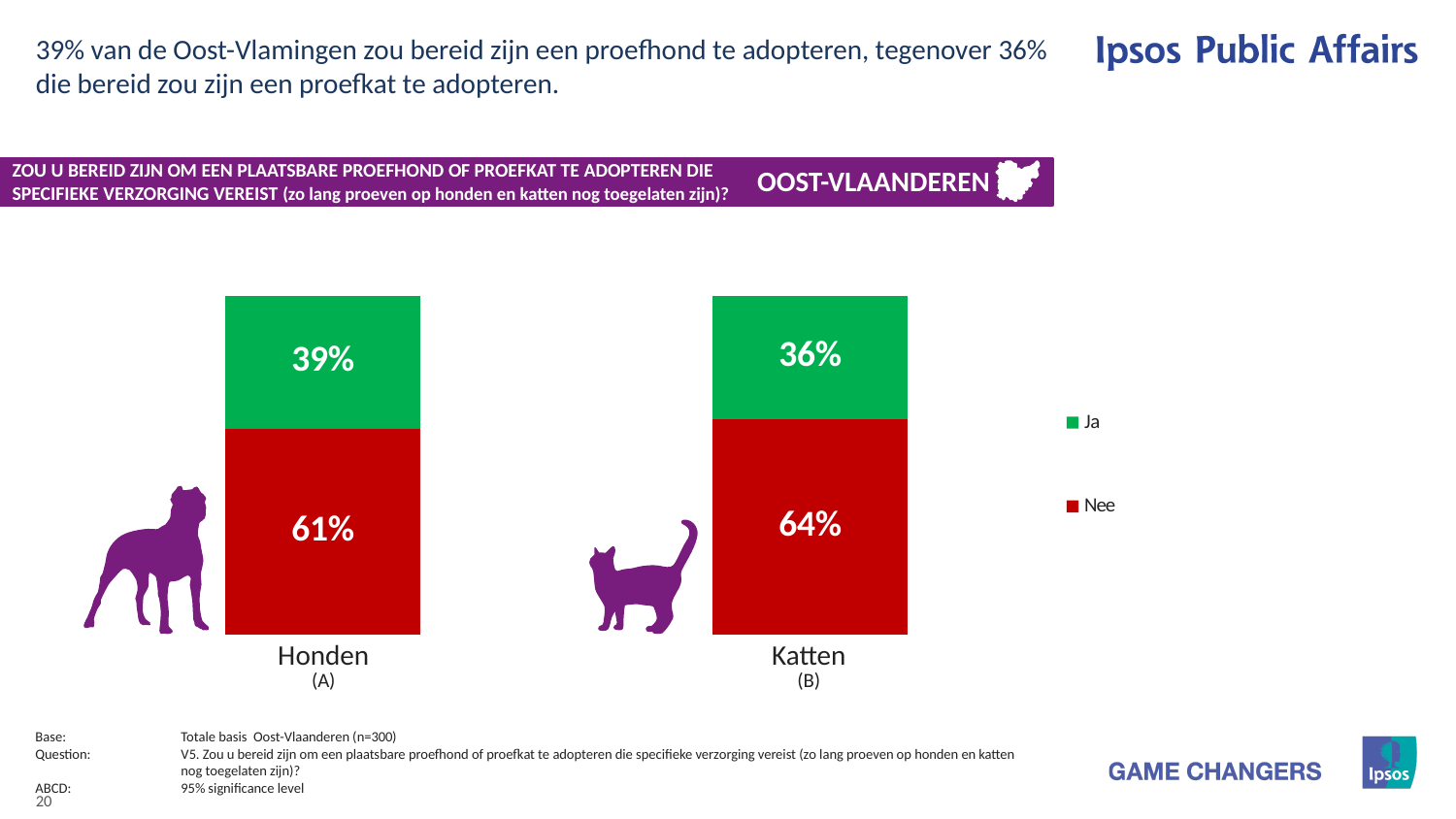
How many series does the legend list? 2 What kind of chart is shown? Stacked bar chart What is the 'Nee' value for Katten? 64% What is the 'Nee' value for Honden? 61% What is the 'Ja' value for Honden? 39% How many categories are shown on the x axis? 2 What is the total of the stacked bar for Honden? 100% What is the difference between the 'Nee' and 'Ja' values for Katten? 28% What is the difference between the 'Ja' values for Honden and Katten? 3% What is the 'Ja' value for Katten? 36% Which category has the higher 'Ja' value, Honden or Katten? Honden Which category has the highest 'Nee' value? Katten